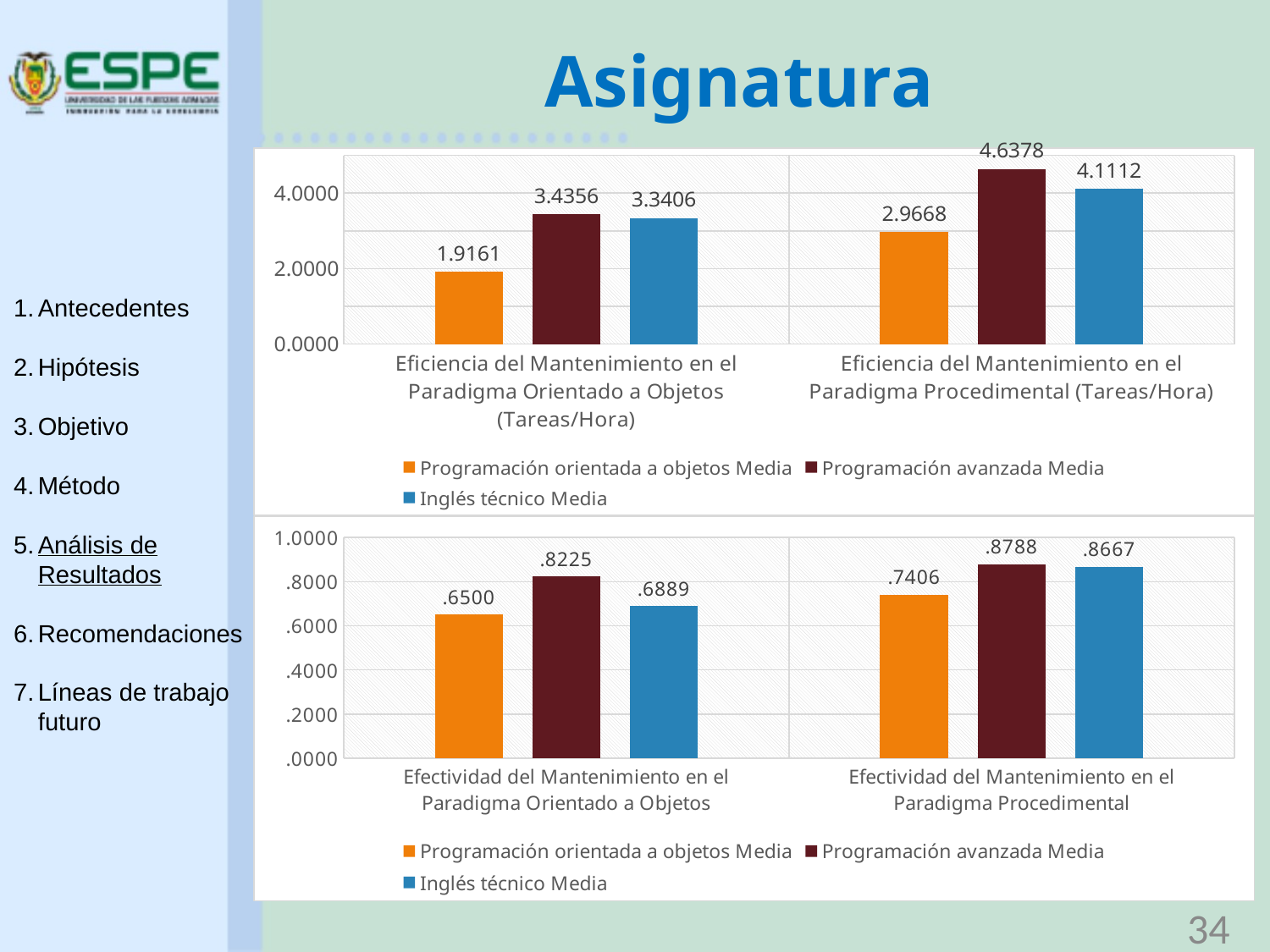
In the top chart, what is the difference between Programación avanzada Media and Programación orientada a objetos Media for Eficiencia del Mantenimiento en el Paradigma Orientado a Objetos (Tareas/Hora)? 1.5195 In the top chart, what is the value of Programación orientada a objetos Media for Eficiencia del Mantenimiento en el Paradigma Orientado a Objetos (Tareas/Hora)? 1.9161 In the bottom chart, which is larger: Programación orientada a objetos Media for Efectividad del Mantenimiento en el Paradigma Orientado a Objetos or for Efectividad del Mantenimiento en el Paradigma Procedimental? Efectividad del Mantenimiento en el Paradigma Procedimental In the top chart, what is the value of Inglés técnico Media for Eficiencia del Mantenimiento en el Paradigma Orientado a Objetos (Tareas/Hora)? 3.3406 How many series does the legend of the bottom chart list? 3 In the top chart, is the value of Programación orientada a objetos Media for Eficiencia del Mantenimiento en el Paradigma Procedimental (Tareas/Hora) greater or less than 2.0000? greater In the bottom chart, what is the value of Inglés técnico Media for Efectividad del Mantenimiento en el Paradigma Procedimental? .8667 In the top chart, what is the value of Programación avanzada Media for Eficiencia del Mantenimiento en el Paradigma Procedimental (Tareas/Hora)? 4.6378 In the top chart, which series has the highest value for Eficiencia del Mantenimiento en el Paradigma Procedimental (Tareas/Hora)? Programación avanzada Media In the bottom chart, what is the value of Programación avanzada Media for Efectividad del Mantenimiento en el Paradigma Orientado a Objetos? .8225 What type of chart is the top chart? Bar chart In the bottom chart, which series has the lowest value for Efectividad del Mantenimiento en el Paradigma Orientado a Objetos? Programación orientada a objetos Media